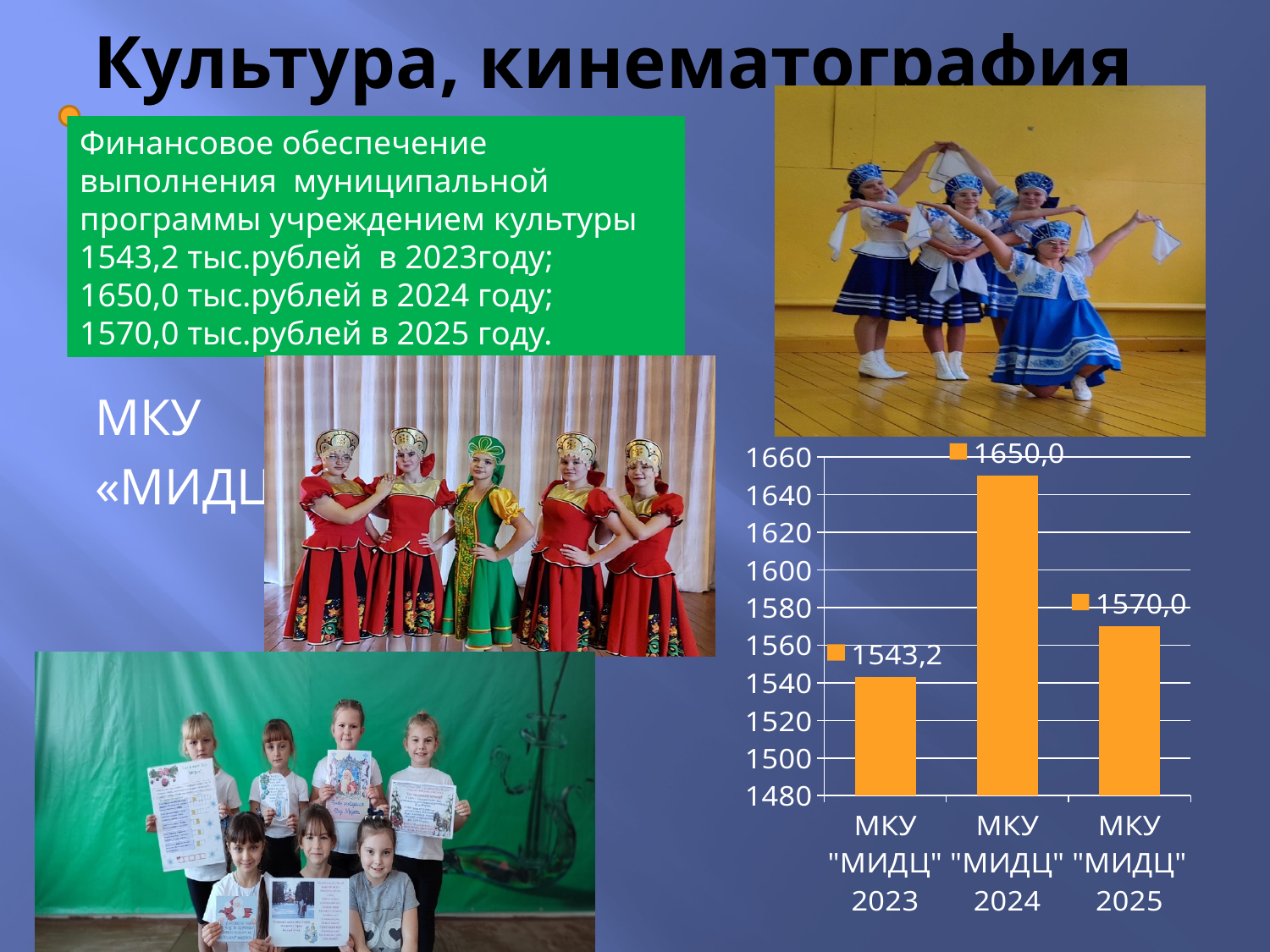
What is the value for МКУ "МИДЦ" 2024 in the chart? 1650,0 What kind of chart is shown on the slide? bar chart What is the difference between the values for 2024 and 2023 in the chart? 106,8 What is the value for МКУ "МИДЦ" 2023 in the chart? 1543,2 Which category has the highest value in the chart? МКУ "МИДЦ" 2024 What is the difference between the values for 2024 and 2025 in the chart? 80,0 Is the value for МКУ "МИДЦ" 2025 greater or less than 1600? less How many categories are shown in the chart? 3 What colour are the bars in the chart? orange Which category has the lowest value in the chart? МКУ "МИДЦ" 2023 What is the value for МКУ "МИДЦ" 2025 in the chart? 1570,0 Which is larger in the chart: the value for 2025 or the value for 2023? 2025